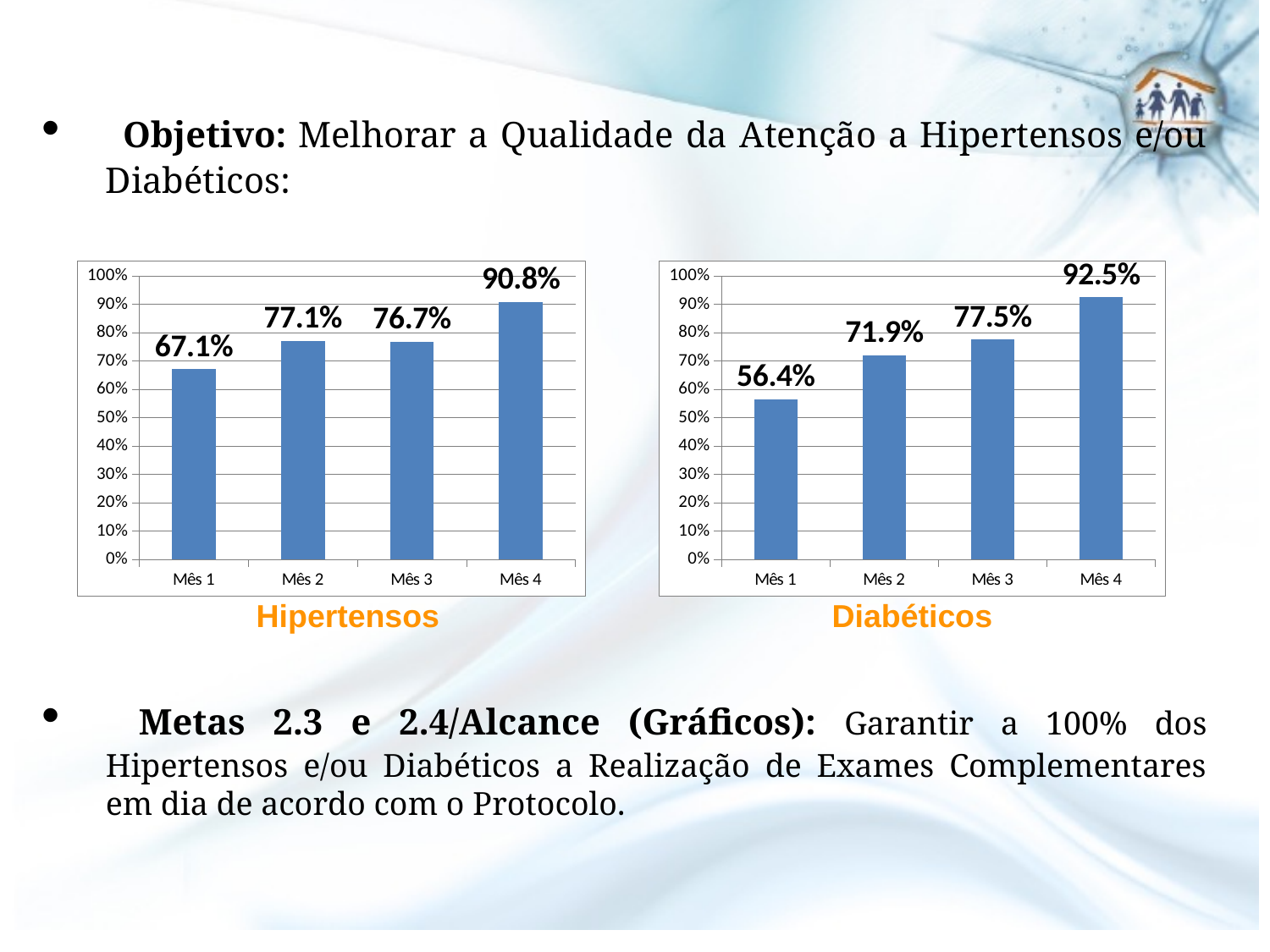
In the Hipertensos chart, what is the value for Mês 1? 67.1% In the Diabéticos chart, is the value for Mês 2 greater or less than 60%? greater What kind of chart is the Hipertensos chart? Bar chart In the Diabéticos chart, what is the difference between Mês 4 and Mês 1? 36.1% How many months are shown in the Diabéticos chart? 4 In the Diabéticos chart, do the values rise or fall from Mês 1 to Mês 4? Rise In the Diabéticos chart, which month has the lowest value? Mês 1 In the Hipertensos chart, which is larger, the value for Mês 2 or Mês 4? Mês 4 In the Diabéticos chart, what is the value for Mês 4? 92.5% In the Hipertensos chart, which month has the highest value? Mês 4 What is the value for Mês 3 in the Diabéticos chart? 77.5% In the Hipertensos chart, what is the difference between Mês 4 and Mês 3? 14.1%